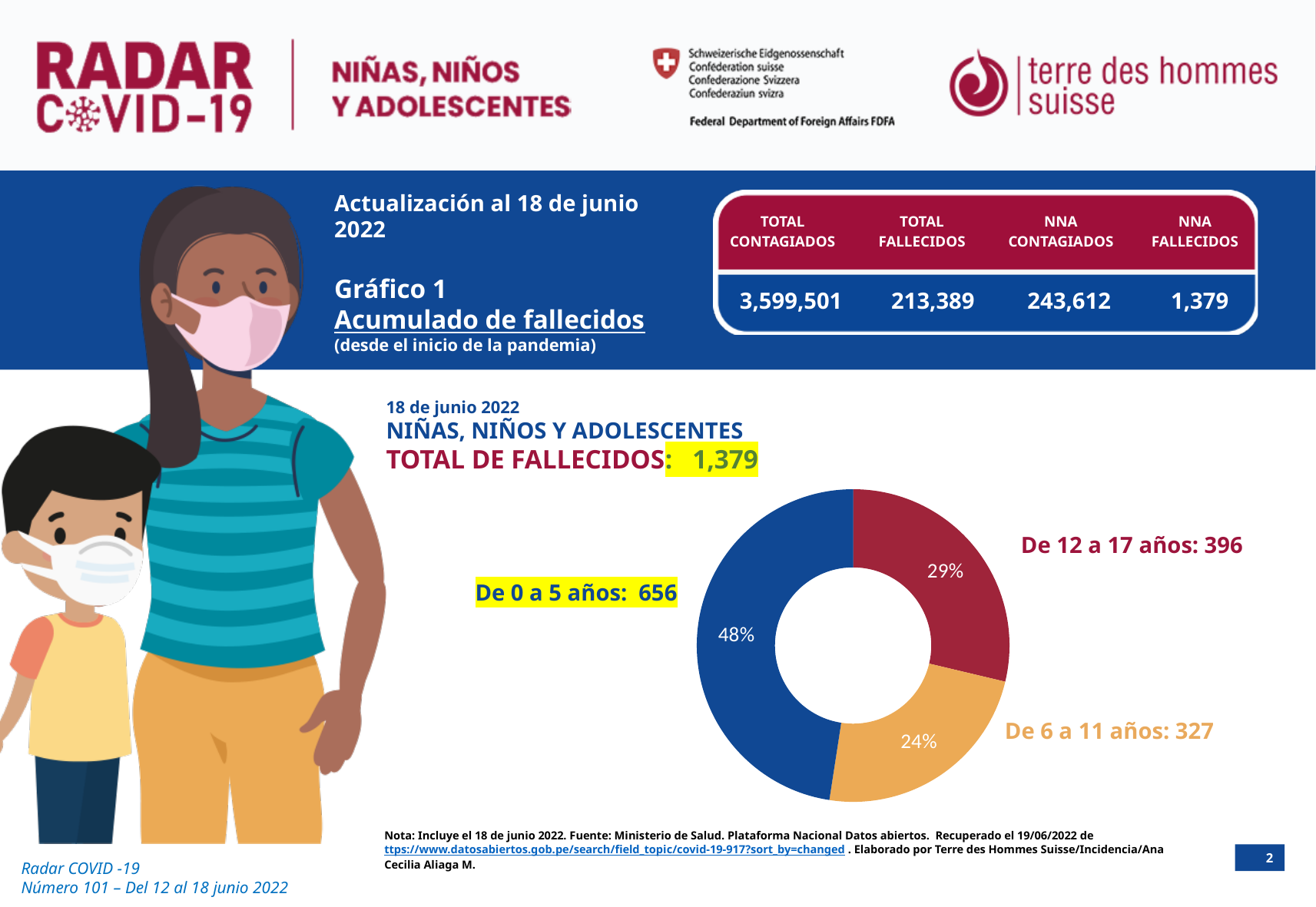
What percentage share of the donut chart corresponds to 'De 0 a 5 años'? 48% What is the difference in deaths between 'De 0 a 5 años' and 'De 12 a 17 años'? 260 What is the number of deaths for the group 'De 0 a 5 años'? 656 What is the total number of deaths (TOTAL DE FALLECIDOS) shown above the chart? 1,379 What is the number of deaths for the group 'De 12 a 17 años'? 396 Which age group has the lowest number of deaths in the chart? De 6 a 11 años What is the number of deaths for the group 'De 6 a 11 años'? 327 What kind of chart is shown on the slide? Donut (pie) chart How many age groups does the donut chart show? 3 Which age group has the highest number of deaths in the chart? De 0 a 5 años What percentage share of the donut chart corresponds to 'De 12 a 17 años'? 29% Which group has more deaths, 'De 6 a 11 años' or 'De 12 a 17 años'? De 12 a 17 años